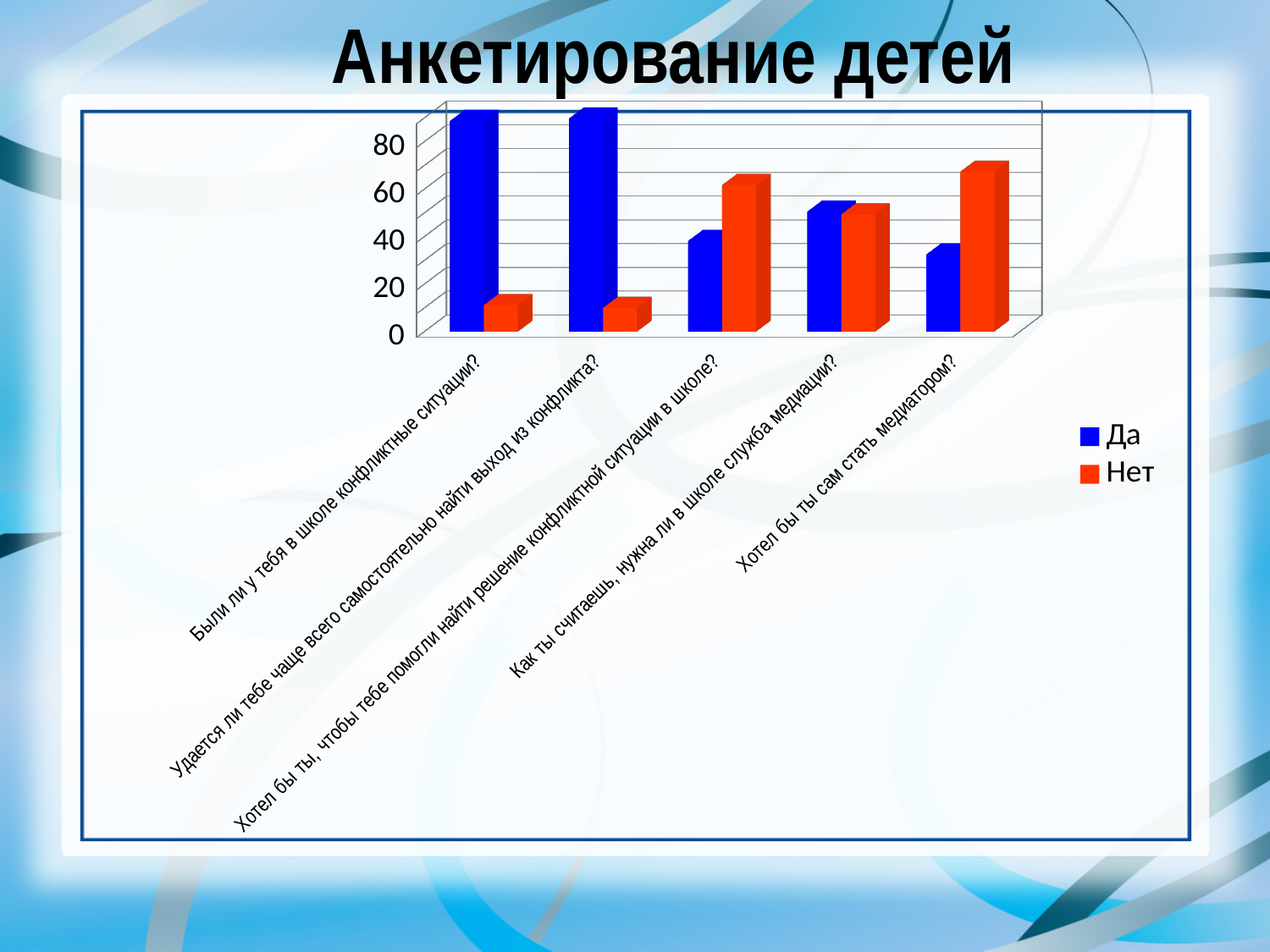
For "Удается ли тебе чаще всего самостоятельно найти выход из конфликта?", which is larger, Да or Нет? Да What kind of chart is shown on the slide? bar chart Is the value for Нет for "Хотел бы ты сам стать медиатором?" greater or less than 60? greater How many questions (categories) are shown on the x axis? 5 Is the value for Да for "Были ли у тебя в школе конфликтные ситуации?" greater or less than 80? greater Is the value for Нет for "Были ли у тебя в школе конфликтные ситуации?" greater or less than 20? less For "Хотел бы ты, чтобы тебе помогли найти решение конфликтной ситуации в школе?", which is larger, Да or Нет? Нет Which question has the highest value for Нет? Хотел бы ты сам стать медиатором? Which question has the lowest value for Да? Хотел бы ты сам стать медиатором? Which series is shown in blue according to the legend? Да How many series does the legend list? 2